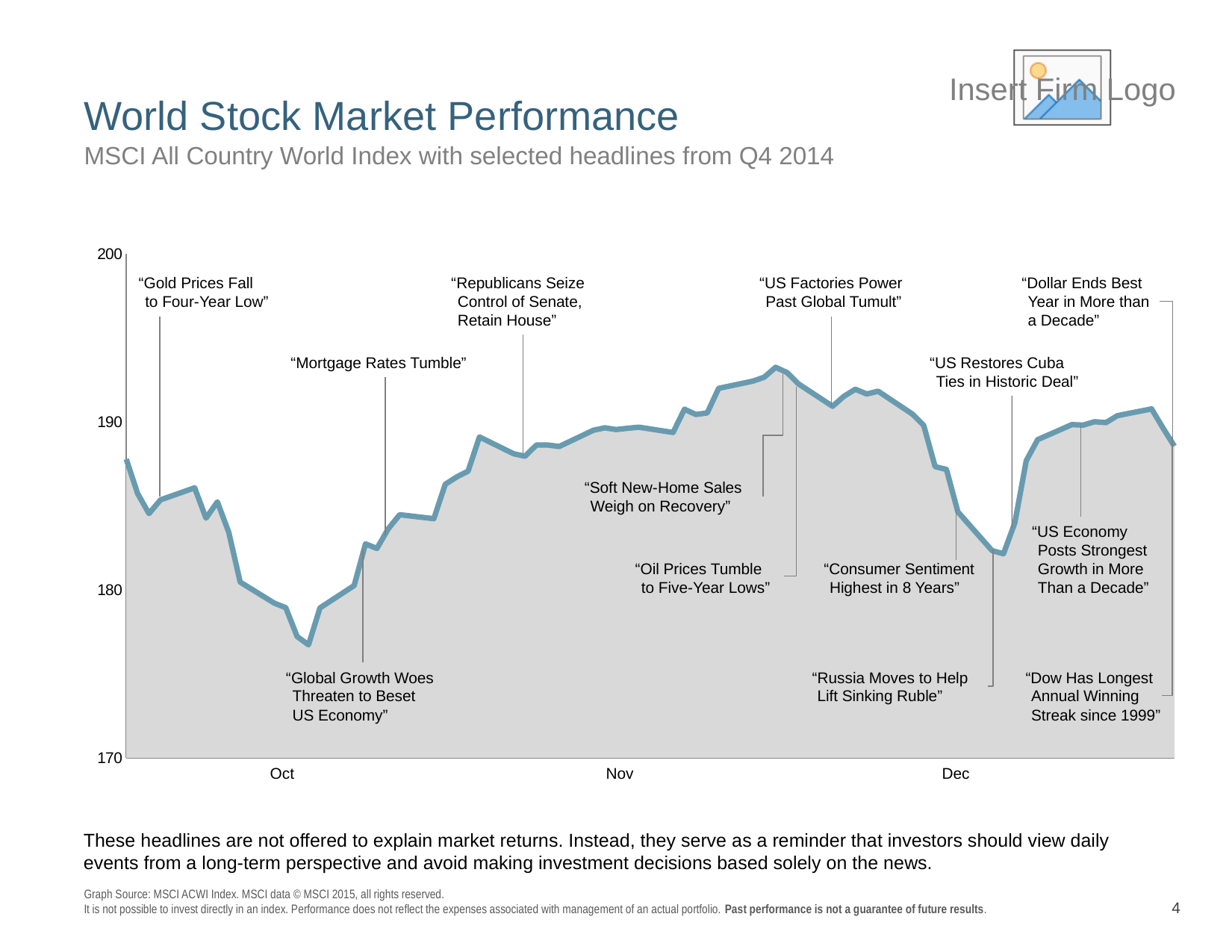
Which index does the chart plot, according to the subtitle? MSCI All Country World Index Is the index value at the "US Factories Power Past Global Tumult" headline greater or less than 190? greater Is the index value at the "Gold Prices Fall to Four-Year Low" headline greater or less than 190? less Is the index value at the "Mortgage Rates Tumble" headline greater or less than 180? greater What is the title of the chart on the slide? World Stock Market Performance How many month labels are shown on the x axis? 3 In which month does the index reach its highest point on the chart? Nov Does the index rise or fall from its mid-October low to its late-November peak? Rise What kind of chart is shown on the slide? Area chart In which month does the index reach its lowest point on the chart? Oct